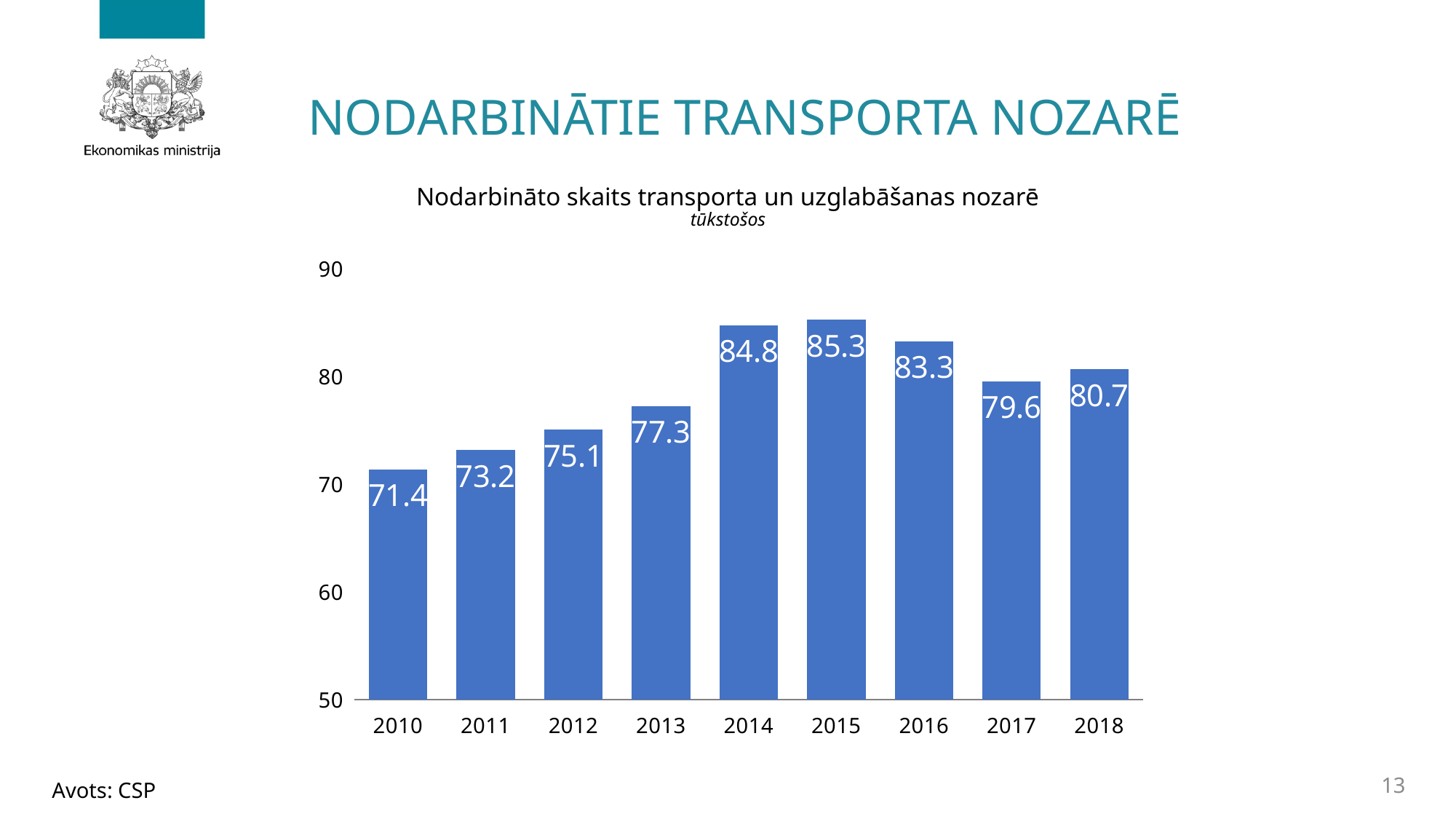
What is the value for 2015? 85.3 Is the value for 2013 greater or less than 80? less Which year has the highest value? 2015 Which year has the lowest value? 2010 What kind of chart is this? bar chart What is the difference between the values for 2016 and 2017? 3.7 What is the value for 2010? 71.4 What is the value for 2018? 80.7 Which is larger, the value for 2014 or the value for 2018? 2014 Do the values rise or fall from 2010 to 2015? rise How many years are shown on the x axis? 9 What is the difference between the values for 2015 and 2010? 13.9